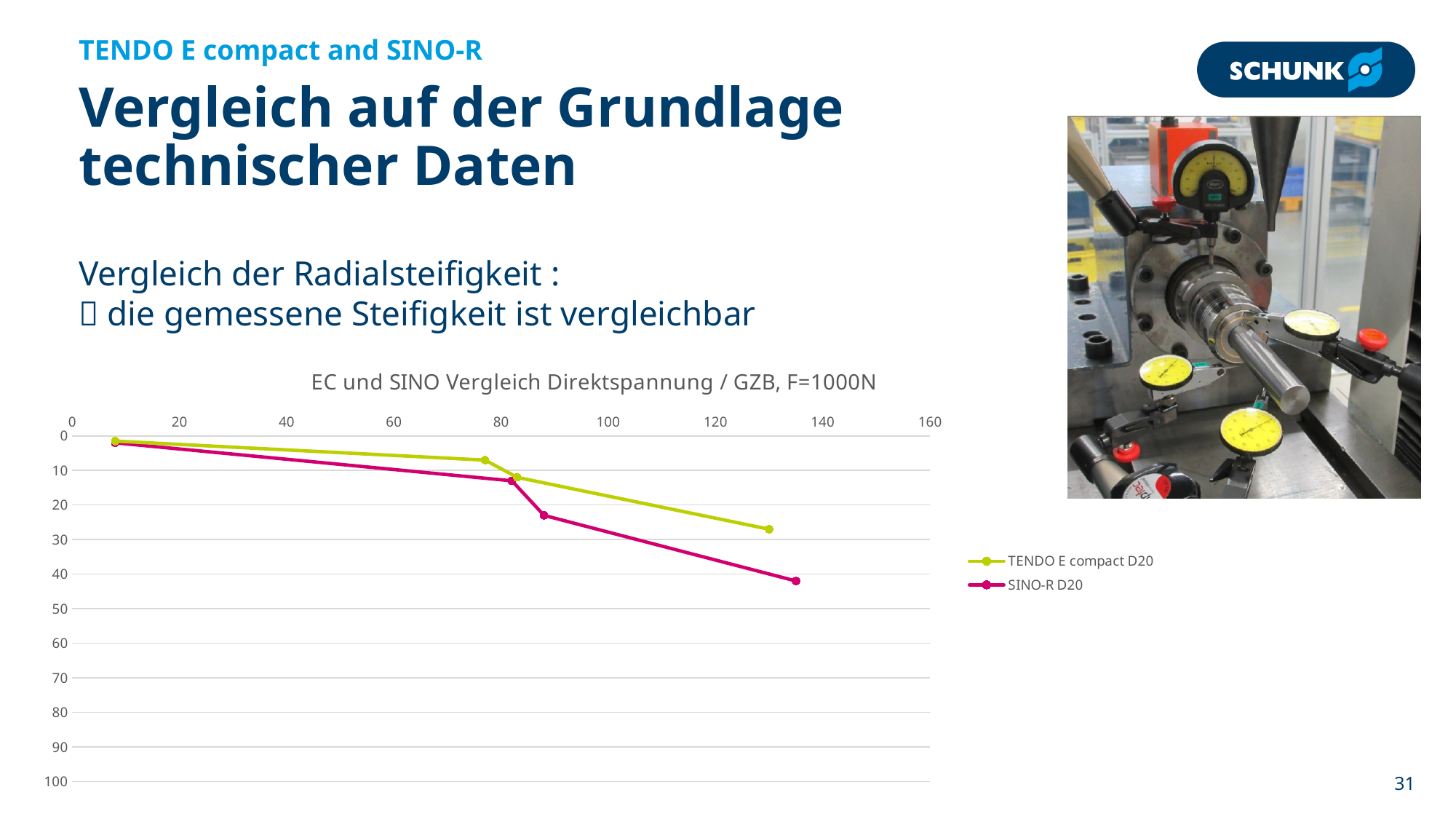
How many data points are plotted for the TENDO E compact D20 series? 4 How many data points are plotted for the SINO-R D20 series? 4 Is the y value of the last SINO-R D20 point greater or less than 30? greater Which series is drawn in magenta in the chart? SINO-R D20 What is the title of the chart? EC und SINO Vergleich Direktspannung / GZB, F=1000N At the right end of the lines, which series has the larger y value, TENDO E compact D20 or SINO-R D20? SINO-R D20 Which series reaches the highest plotted y value in the chart? SINO-R D20 Along the x axis, do the y values of the SINO-R D20 series increase or decrease? increase Is the y value of the last TENDO E compact D20 point greater or less than 40? less How many series does the chart legend list? 2 What kind of chart is shown on the slide? line chart Is the y value of the second TENDO E compact D20 point (near x=80) greater or less than 10? less